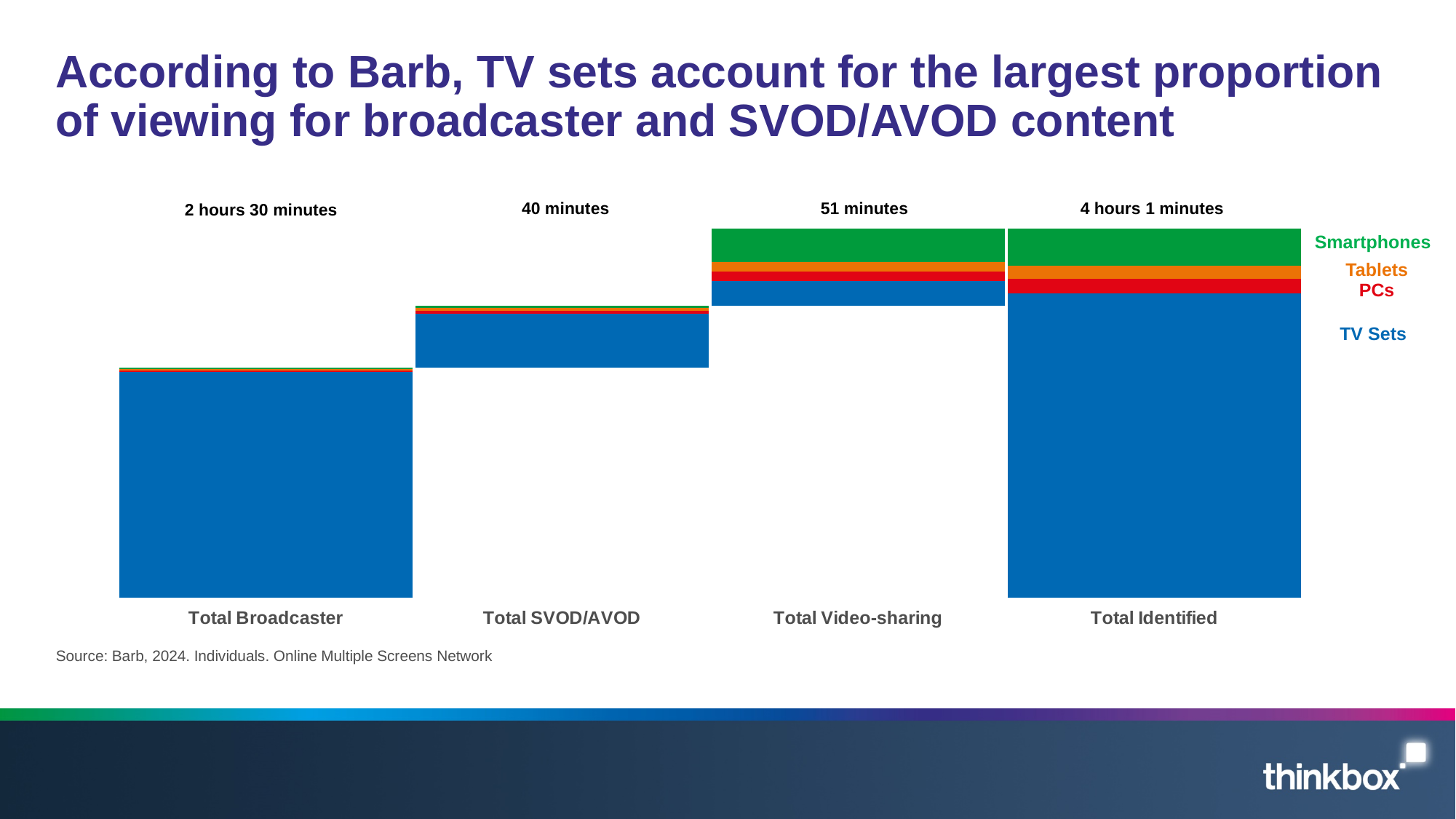
Which has a larger total viewing time, Total Video-sharing or Total SVOD/AVOD? Total Video-sharing How many device types does the legend list? 4 What is the total viewing time shown for Total Broadcaster? 2 hours 30 minutes What kind of chart is shown on the slide? Stacked bar chart What is the total viewing time shown for Total Video-sharing? 51 minutes What is the total viewing time shown for Total Identified? 4 hours 1 minutes Which category has the highest total viewing time? Total Identified Which device type accounts for the largest part of the Total Broadcaster bar? TV Sets How many minutes more is the Total Video-sharing total than the Total SVOD/AVOD total? 11 minutes Which category has the lowest total viewing time? Total SVOD/AVOD What is the total viewing time shown for Total SVOD/AVOD? 40 minutes How many categories are shown along the x axis? 4